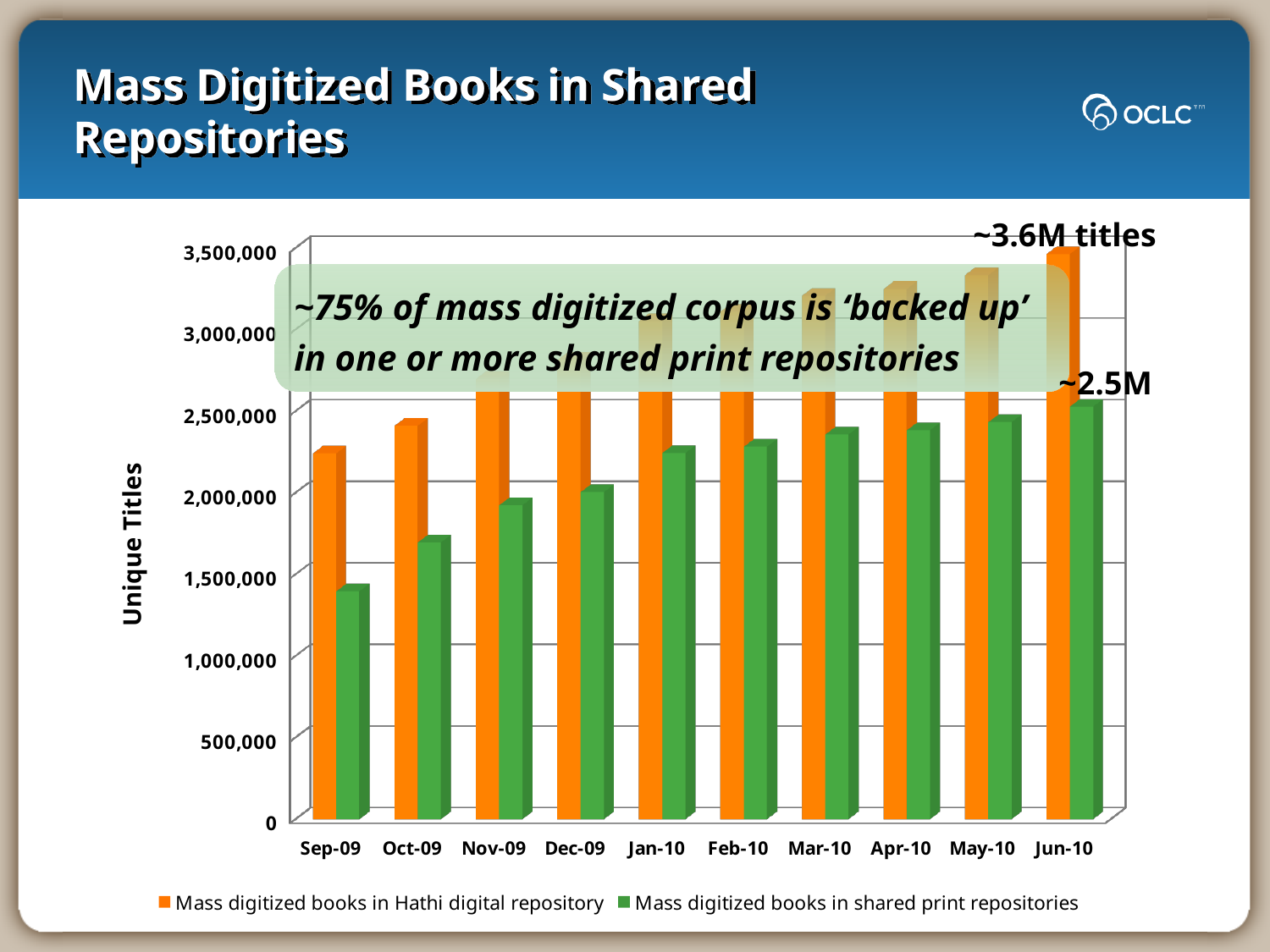
Is the value for mass digitized books in shared print repositories in Jan-10 greater or less than 2,000,000? greater What kind of chart is shown on the slide? bar chart Is the value for mass digitized books in Hathi digital repository in Sep-09 greater or less than 2,000,000? greater Which series is shown in green? Mass digitized books in shared print repositories In Sep-09, which is larger: mass digitized books in Hathi digital repository or mass digitized books in shared print repositories? Mass digitized books in Hathi digital repository Do the values for mass digitized books in shared print repositories rise or fall from Sep-09 to Jun-10? rise What is the label on the y axis? Unique Titles In which month is the value for mass digitized books in Hathi digital repository highest? Jun-10 Is the value for mass digitized books in shared print repositories in Sep-09 greater or less than 1,500,000? less In which month is the value for mass digitized books in shared print repositories lowest? Sep-09 How many months are shown on the x axis? 10 How many series does the legend list? 2